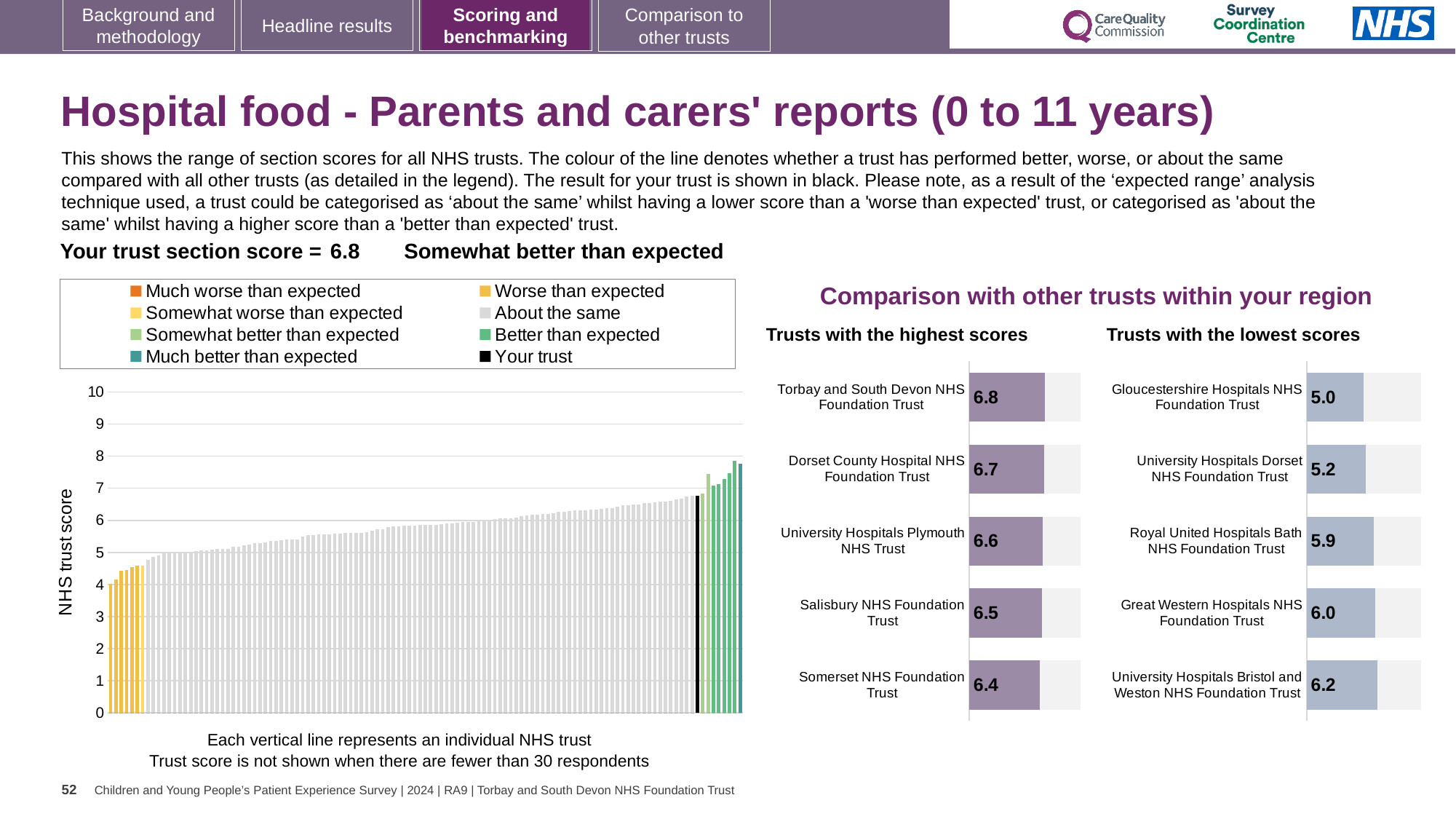
In the 'Trusts with the highest scores' chart, what is the difference between the scores of Torbay and South Devon NHS Foundation Trust and Somerset NHS Foundation Trust? 0.4 In the 'NHS trust score' chart on the left, is the value of the black 'Your trust' bar greater or less than 6? greater What kind of chart is the large 'NHS trust score' chart on the left? Bar chart In the 'Trusts with the lowest scores' chart, which trust has the highest score? University Hospitals Bristol and Weston NHS Foundation Trust In the 'Trusts with the highest scores' chart, how many trusts are shown? 5 In the 'Trusts with the highest scores' chart, which trust has the highest score? Torbay and South Devon NHS Foundation Trust In the 'Trusts with the lowest scores' chart, which is larger: the score for Royal United Hospitals Bath NHS Foundation Trust or University Hospitals Dorset NHS Foundation Trust? Royal United Hospitals Bath NHS Foundation Trust In the 'Trusts with the highest scores' chart, what is the score for Dorset County Hospital NHS Foundation Trust? 6.7 In the 'Trusts with the lowest scores' chart, what is the difference between the scores of University Hospitals Bristol and Weston NHS Foundation Trust and Gloucestershire Hospitals NHS Foundation Trust? 1.2 In the 'NHS trust score' chart on the left, do the bar values rise or fall from left to right? Rise How many entries does the legend of the 'NHS trust score' chart on the left list? 8 In the 'Trusts with the lowest scores' chart, what is the score for Gloucestershire Hospitals NHS Foundation Trust? 5.0